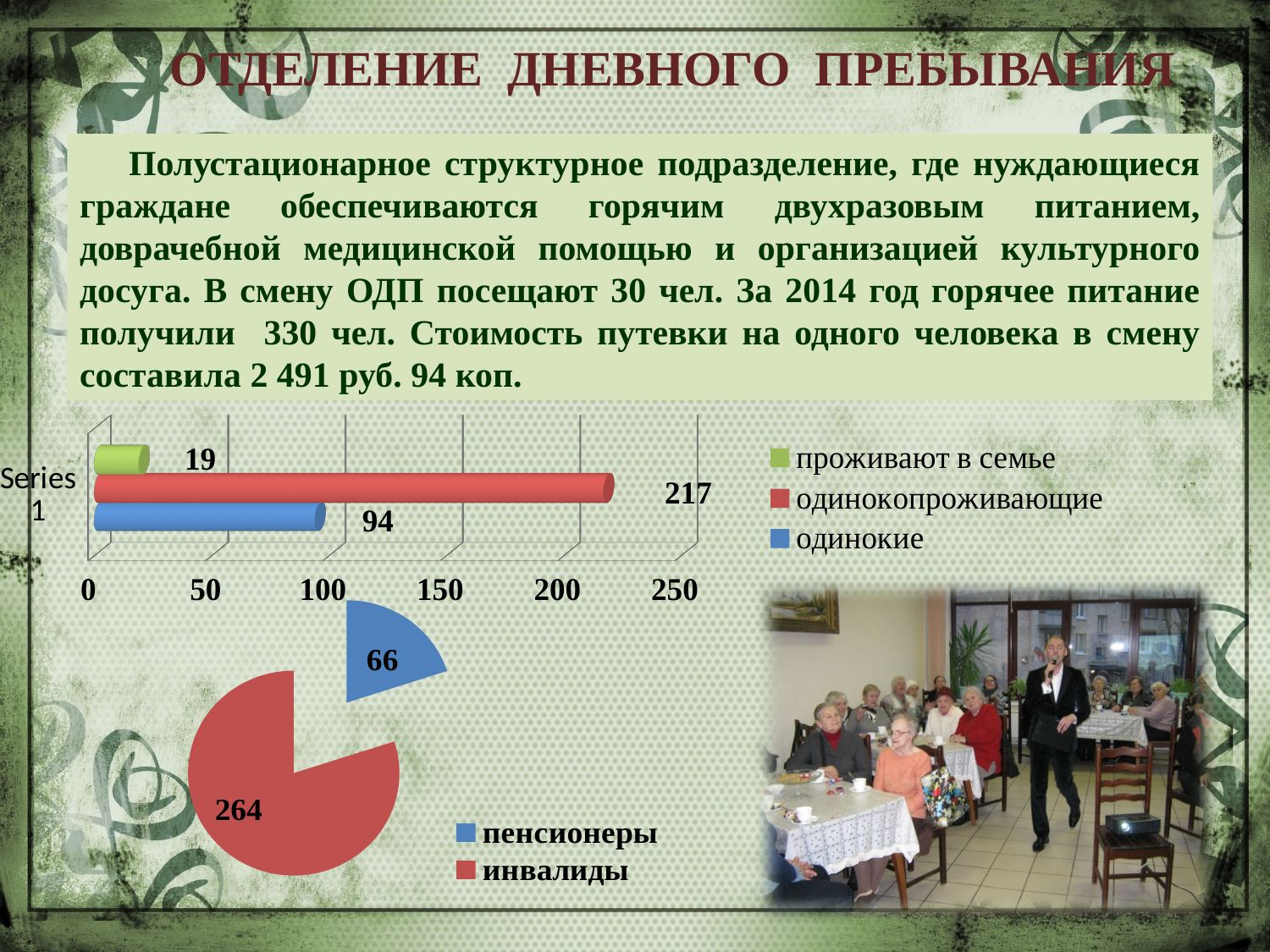
In the bar chart at the top, which series has the lowest value? проживают в семье In the pie chart at the bottom, what is the value for инвалиды? 264 What kind of chart is the chart at the top of the slide? bar chart In the bar chart at the top, what is the value for одинокопроживающие? 217 In the pie chart at the bottom, what share of the total does инвалиды represent? 80% In the bar chart at the top, which series has the highest value? одинокопроживающие In the pie chart at the bottom, what is the value for пенсионеры? 66 In the bar chart at the top, what is the difference between одинокопроживающие and одинокие? 123 In the pie chart at the bottom, which slice is larger, пенсионеры or инвалиды? инвалиды In the bar chart at the top, how many series does the legend list? 3 In the bar chart at the top, what is the value for одинокие? 94 In the bar chart at the top, what is the value for проживают в семье? 19